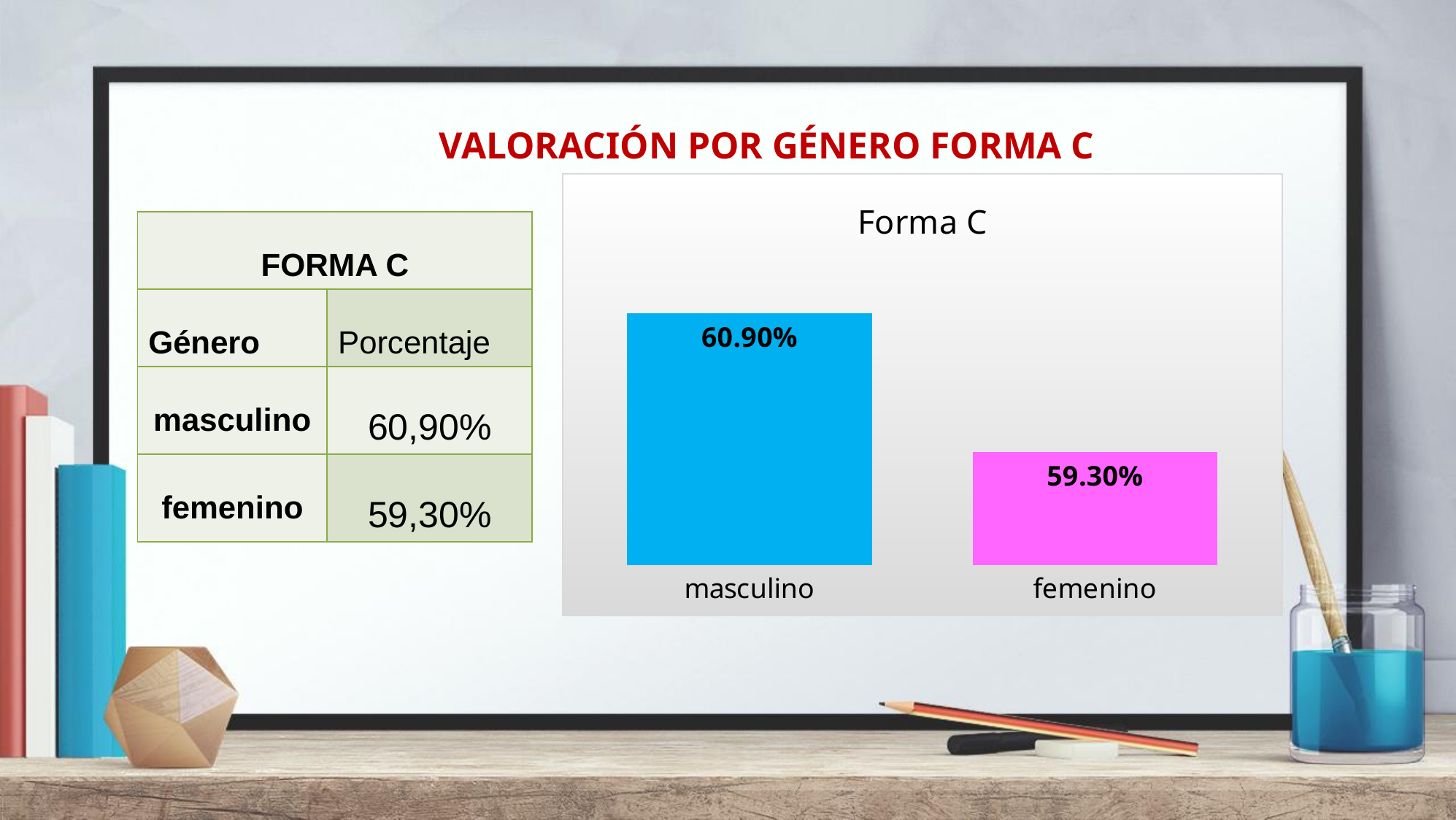
What is the title of the chart on the slide? Forma C What colour is the femenino bar in the Forma C chart? magenta (pink) Which category has the lowest value in the Forma C chart? femenino Which is larger in the Forma C chart, masculino or femenino? masculino How many categories are shown in the Forma C chart? 2 What is the difference between the masculino and femenino values in the Forma C chart? 1.60% What kind of chart is the Forma C chart? bar chart What is the value for femenino in the Forma C chart? 59.30% What is the value for masculino in the Forma C chart? 60.90% Which category has the highest value in the Forma C chart? masculino